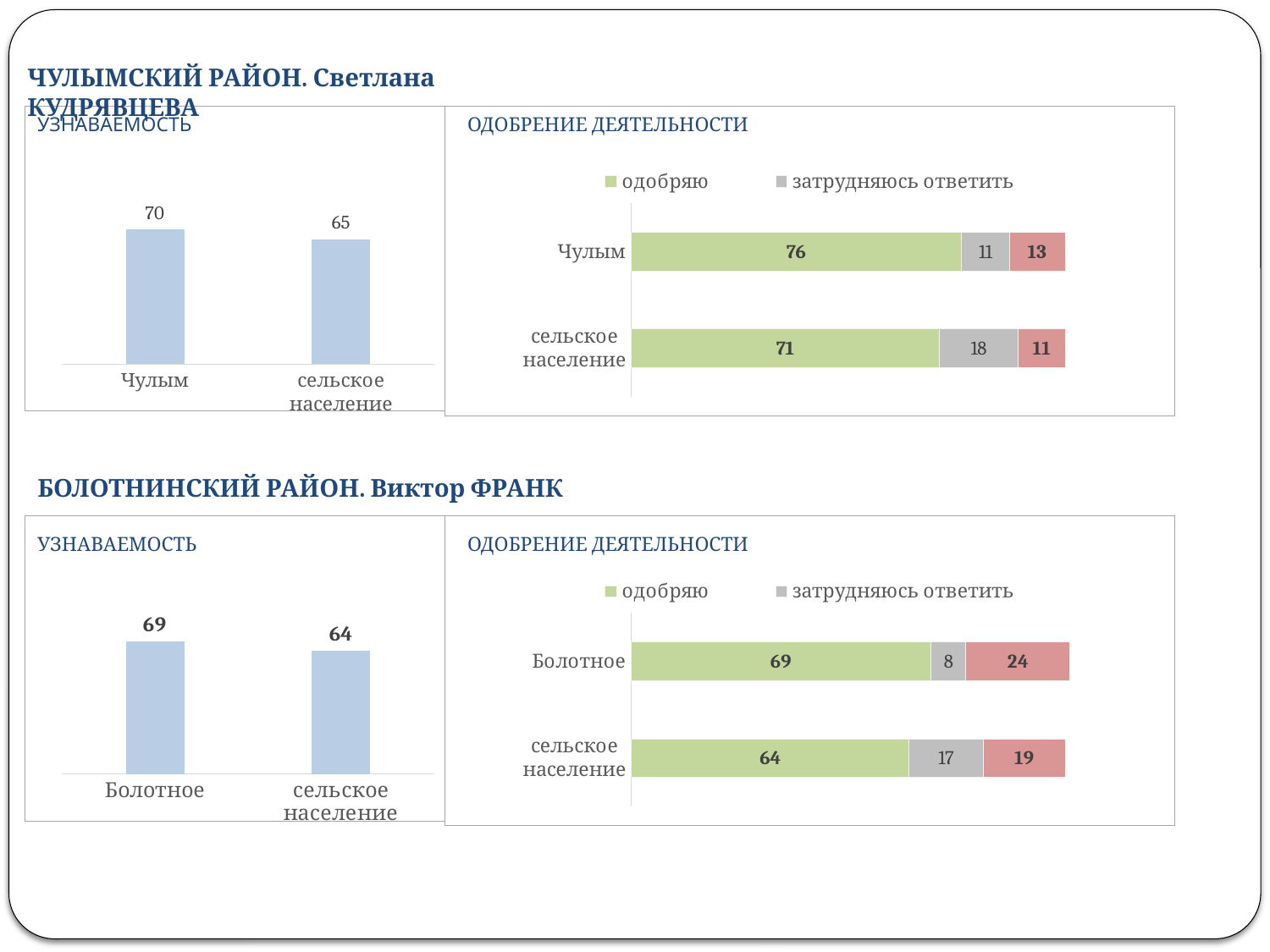
In the УЗНАВАЕМОСТЬ chart for ЧУЛЫМСКИЙ РАЙОН, what is the value for Чулым? 70 In the ОДОБРЕНИЕ ДЕЯТЕЛЬНОСТИ chart for БОЛОТНИНСКИЙ РАЙОН, what is the одобряю value for сельское население? 64 In the ОДОБРЕНИЕ ДЕЯТЕЛЬНОСТИ chart for ЧУЛЫМСКИЙ РАЙОН, what is the total of the stacked bar for Чулым? 100 In the УЗНАВАЕМОСТЬ chart for БОЛОТНИНСКИЙ РАЙОН, which category has the lowest value? сельское население In the УЗНАВАЕМОСТЬ chart for ЧУЛЫМСКИЙ РАЙОН, what is the value for сельское население? 65 What type of chart is the УЗНАВАЕМОСТЬ chart for БОЛОТНИНСКИЙ РАЙОН? bar chart In the ОДОБРЕНИЕ ДЕЯТЕЛЬНОСТИ chart for ЧУЛЫМСКИЙ РАЙОН, what is the одобряю value for Чулым? 76 In the ОДОБРЕНИЕ ДЕЯТЕЛЬНОСТИ chart for ЧУЛЫМСКИЙ РАЙОН, what is the затрудняюсь ответить value for сельское население? 18 In the УЗНАВАЕМОСТЬ chart for БОЛОТНИНСКИЙ РАЙОН, what is the value for Болотное? 69 In the УЗНАВАЕМОСТЬ chart for ЧУЛЫМСКИЙ РАЙОН, what is the difference between Чулым and сельское население? 5 In the ОДОБРЕНИЕ ДЕЯТЕЛЬНОСТИ chart for БОЛОТНИНСКИЙ РАЙОН, which is larger: the затрудняюсь ответить value for Болотное or for сельское население? сельское население In the ОДОБРЕНИЕ ДЕЯТЕЛЬНОСТИ chart for БОЛОТНИНСКИЙ РАЙОН, what is the total of the stacked bar for сельское население? 100